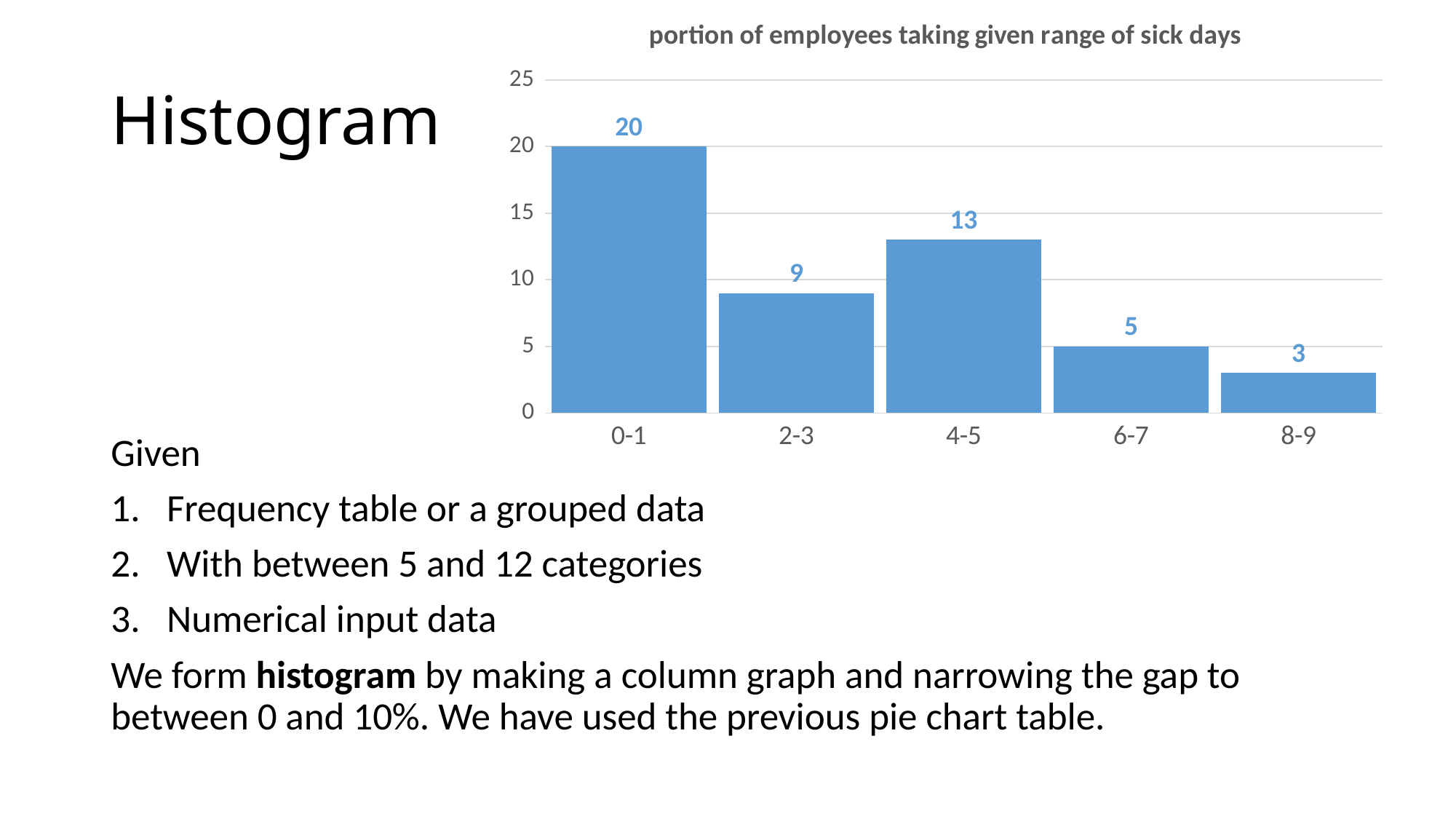
What is the title of the chart? portion of employees taking given range of sick days What is the difference between the values for 0-1 and 2-3? 11 Which is larger, the value for 2-3 or the value for 4-5? 4-5 What is the value for the 0-1 category? 20 What is the value for the 8-9 category? 3 What is the difference between the values for 4-5 and 6-7? 8 Which category has the highest value? 0-1 What kind of chart is shown on the slide? bar chart What is the value for the 4-5 category? 13 How many categories are shown on the x axis? 5 Which category has the lowest value? 8-9 Is the value for 6-7 greater or less than 10? less